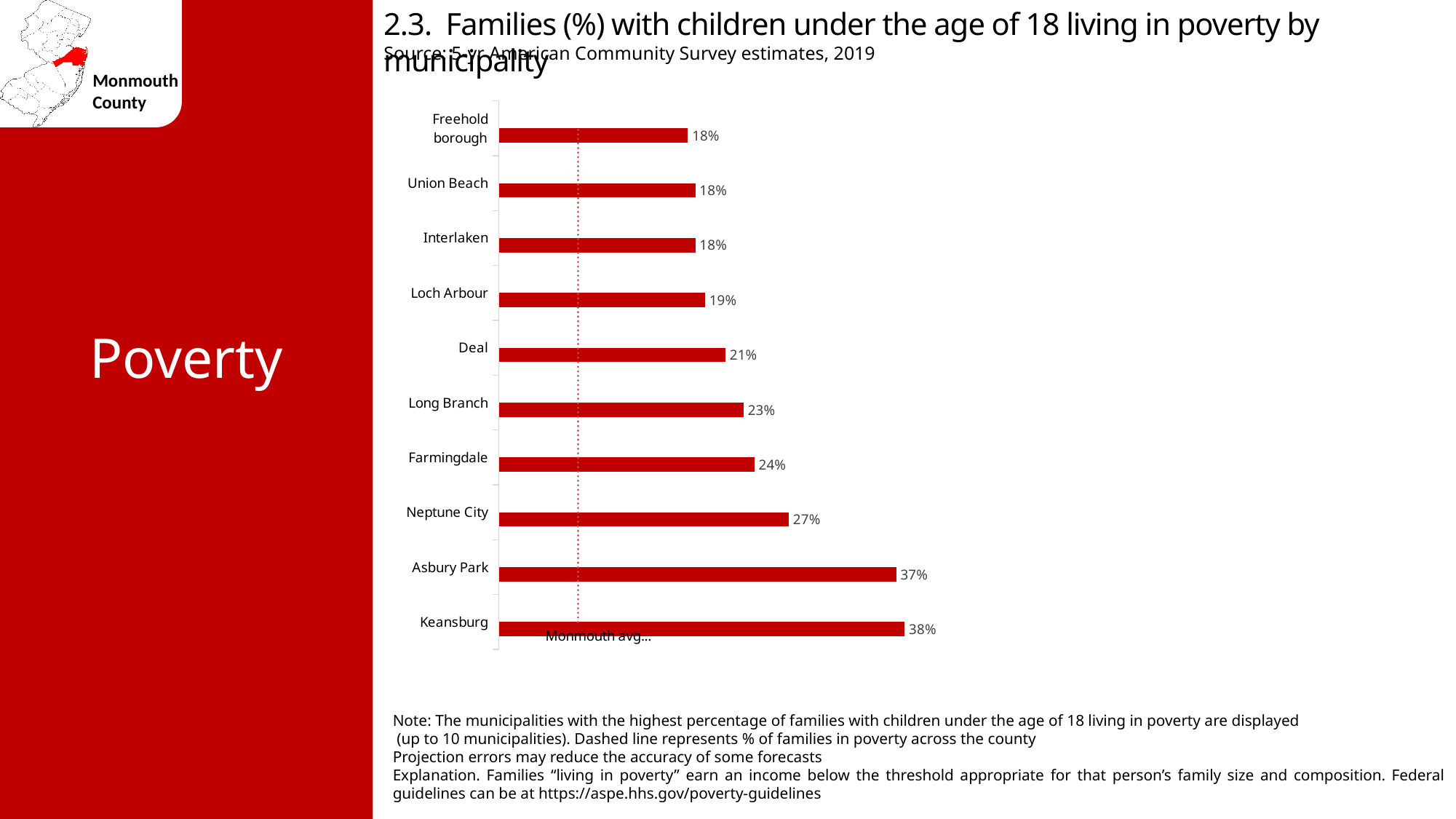
What percentage of families with children under 18 live in poverty in Keansburg? 38% What type of chart is used on this slide? Bar chart Which has a higher value, Deal or Farmingdale? Farmingdale What is the value shown for Loch Arbour? 19% What is the difference between the values for Keansburg and Neptune City? 11% What is the difference between the values for Asbury Park and Farmingdale? 13% Which municipality has the highest percentage of families with children under 18 living in poverty? Keansburg What is the value shown for Neptune City? 27% Which has a higher value, Long Branch or Loch Arbour? Long Branch What does the dashed vertical line on the chart represent? Monmouth avg (county average) What is the value shown for Long Branch? 23% How many municipalities are shown in the chart? 10